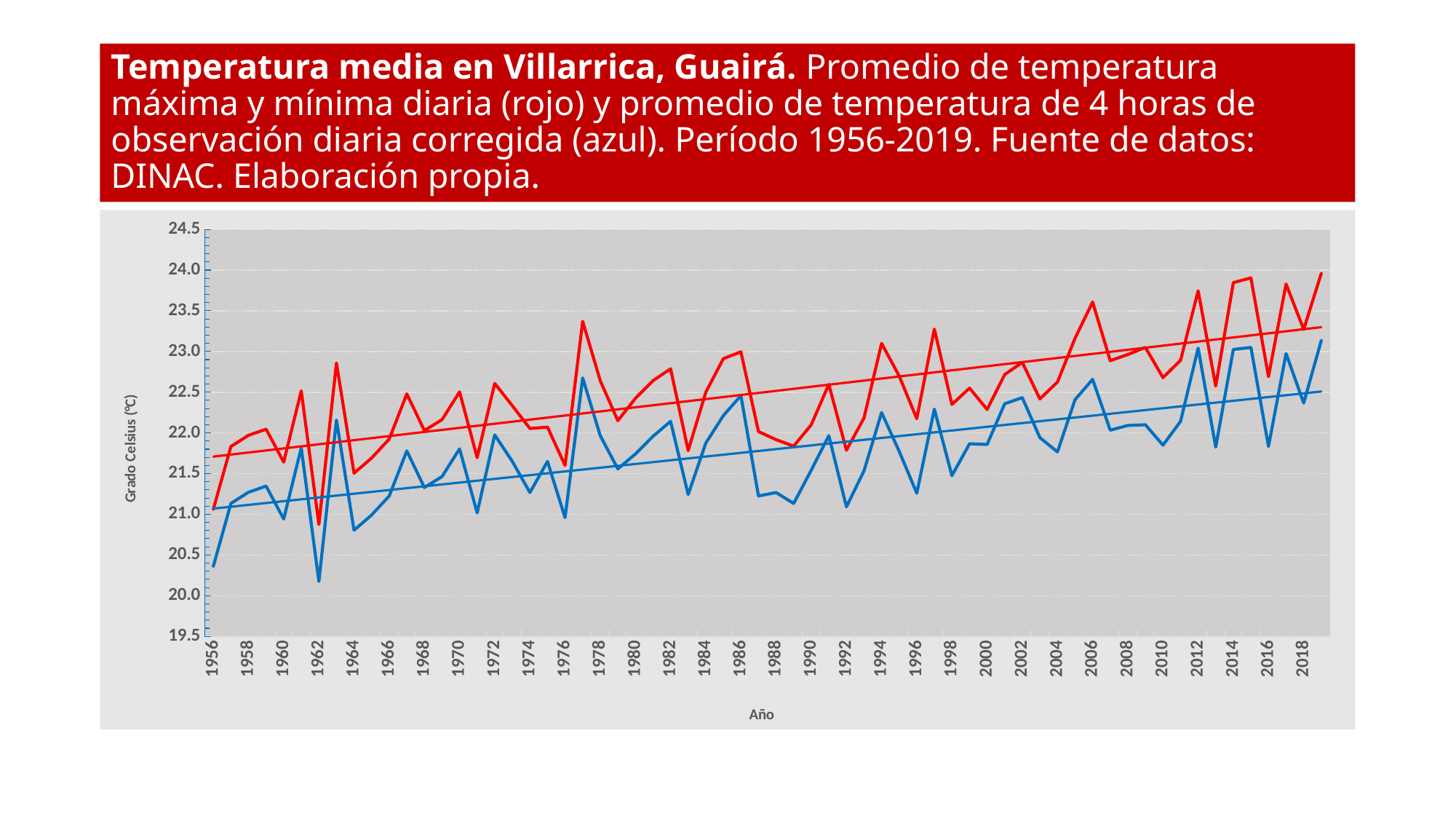
Is the value of the blue line in 1962 greater or less than 20.5? less In which year does the blue line reach its lowest value? 1962 Is the value of the blue line in 1964 greater or less than 21.0? less In 1990, which line has the higher value, the red line or the blue line? red line Is the value of the blue line in 2012 greater or less than 22.5? greater Do the temperature values generally rise or fall from 1956 to 2019? rise What kind of chart is shown on the slide? line chart What is the label of the vertical axis? Grado Celsius (°C) In which year does the red line reach its lowest value? 1962